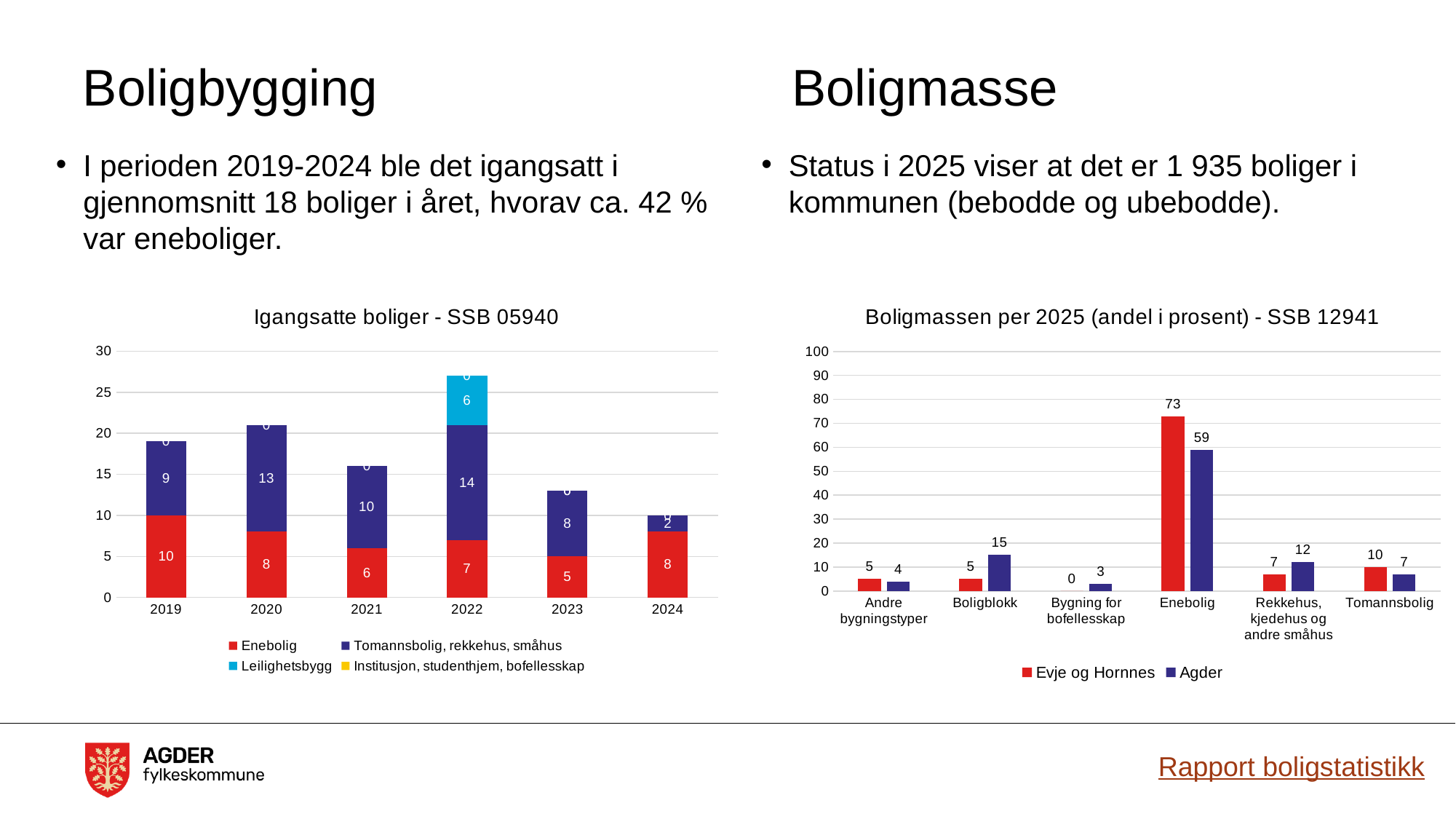
What kind of chart is 'Igangsatte boliger - SSB 05940'? Stacked bar chart In the 'Boligmassen per 2025 (andel i prosent) - SSB 12941' chart, what is the value for Agder for Boligblokk? 15 In the 'Igangsatte boliger - SSB 05940' chart, how many series does the legend list? 4 In the 'Igangsatte boliger - SSB 05940' chart, what is the value for Enebolig in 2019? 10 In the 'Igangsatte boliger - SSB 05940' chart, what is the total of the stacked bar for 2022? 27 In the 'Boligmassen per 2025 (andel i prosent) - SSB 12941' chart, which is larger for Tomannsbolig: Evje og Hornnes or Agder? Evje og Hornnes In the 'Boligmassen per 2025 (andel i prosent) - SSB 12941' chart, what is the difference between Evje og Hornnes and Agder for Enebolig? 14 In the 'Igangsatte boliger - SSB 05940' chart, what is the difference between the Enebolig values for 2019 and 2023? 5 In the 'Boligmassen per 2025 (andel i prosent) - SSB 12941' chart, what is the value for Evje og Hornnes for Enebolig? 73 In the 'Boligmassen per 2025 (andel i prosent) - SSB 12941' chart, how many categories are shown on the x axis? 6 In the 'Igangsatte boliger - SSB 05940' chart, which year has the lowest total of igangsatte boliger? 2024 In the 'Igangsatte boliger - SSB 05940' chart, what is the value for Tomannsbolig, rekkehus, småhus in 2022? 14